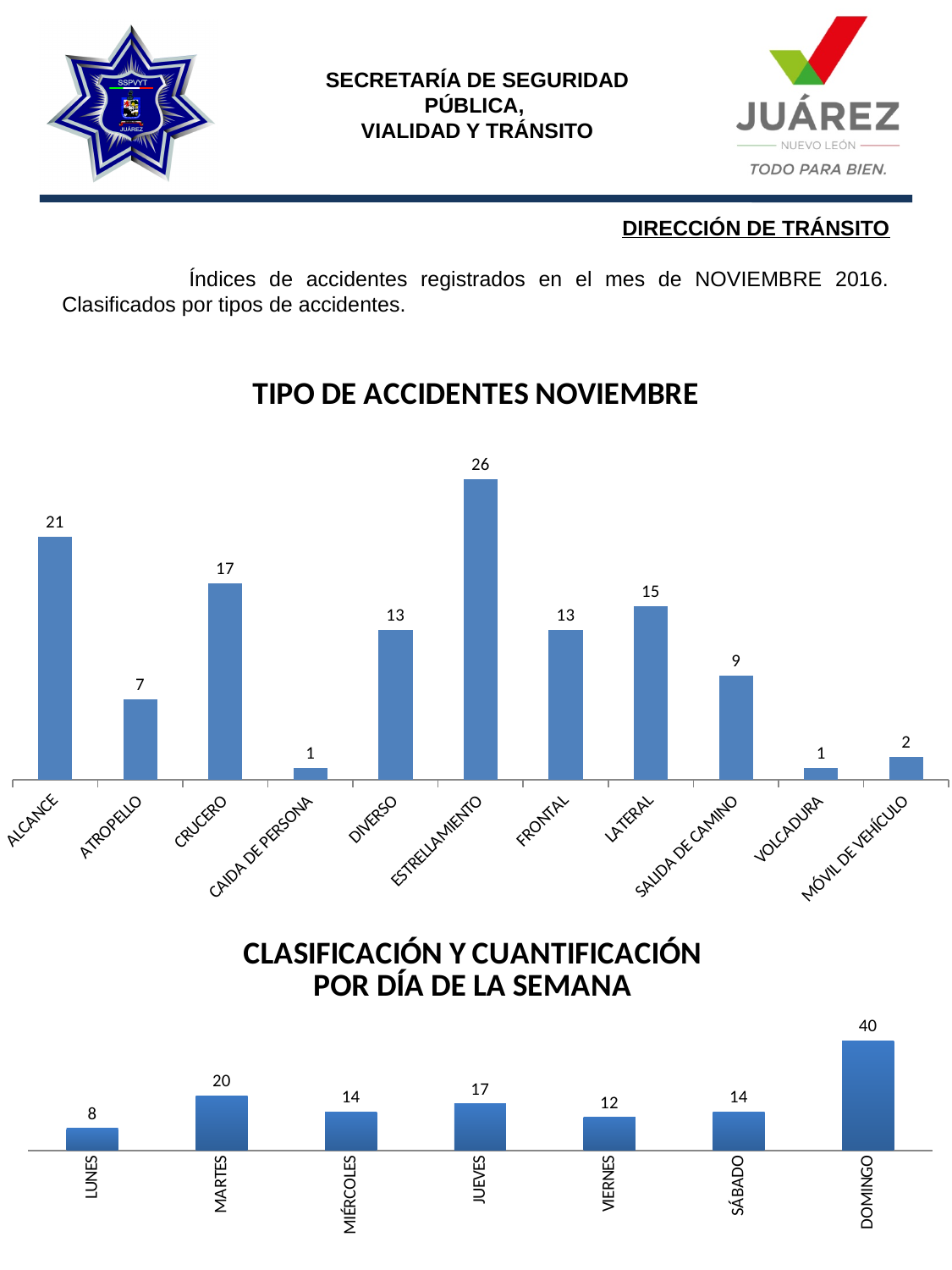
In the 'TIPO DE ACCIDENTES NOVIEMBRE' chart, which is larger, LATERAL or FRONTAL? LATERAL In the 'TIPO DE ACCIDENTES NOVIEMBRE' chart, which category has the highest value? ESTRELLAMIENTO In the 'CLASIFICACIÓN Y CUANTIFICACIÓN POR DÍA DE LA SEMANA' chart, which day has the lowest value? LUNES In the 'CLASIFICACIÓN Y CUANTIFICACIÓN POR DÍA DE LA SEMANA' chart, what is the value for DOMINGO? 40 What kind of chart is 'TIPO DE ACCIDENTES NOVIEMBRE'? Bar chart In the 'TIPO DE ACCIDENTES NOVIEMBRE' chart, what is the value for ESTRELLAMIENTO? 26 How many categories are shown in the 'TIPO DE ACCIDENTES NOVIEMBRE' chart? 11 In the 'TIPO DE ACCIDENTES NOVIEMBRE' chart, what is the value for SALIDA DE CAMINO? 9 In the 'CLASIFICACIÓN Y CUANTIFICACIÓN POR DÍA DE LA SEMANA' chart, which is larger, JUEVES or SÁBADO? JUEVES How many days are shown in the 'CLASIFICACIÓN Y CUANTIFICACIÓN POR DÍA DE LA SEMANA' chart? 7 In the 'TIPO DE ACCIDENTES NOVIEMBRE' chart, what is the difference between ALCANCE and CRUCERO? 4 In the 'CLASIFICACIÓN Y CUANTIFICACIÓN POR DÍA DE LA SEMANA' chart, what is the difference between MARTES and VIERNES? 8